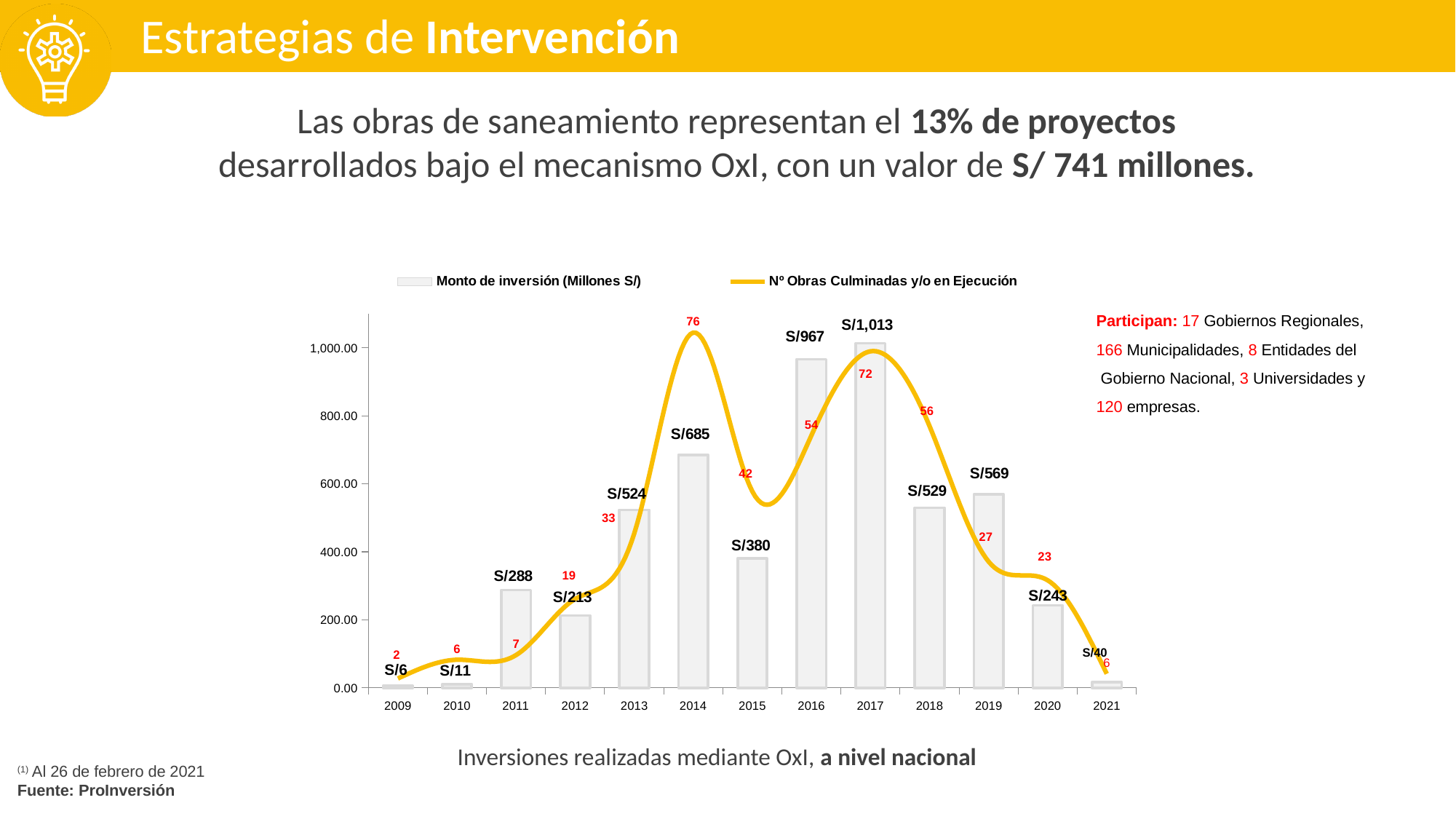
Which year has a higher Nº Obras Culminadas y/o en Ejecución, 2016 or 2018? 2018 What is the caption shown below the chart? Inversiones realizadas mediante OxI, a nivel nacional What is the difference in Monto de inversión between 2016 and 2015? S/587 What is the Nº Obras Culminadas y/o en Ejecución value for 2014? 76 How many series does the chart legend list? 2 Which year has the lowest Monto de inversión? 2009 What is the Monto de inversión (Millones S/) for 2017? S/1,013 What kind of chart is used to show the Monto de inversión series? Bar chart How many years are shown on the x axis of the chart? 13 What is the Monto de inversión for 2021? S/40 Does the Nº Obras Culminadas y/o en Ejecución value rise or fall from 2017 to 2021? Fall Which year has the highest Monto de inversión? 2017